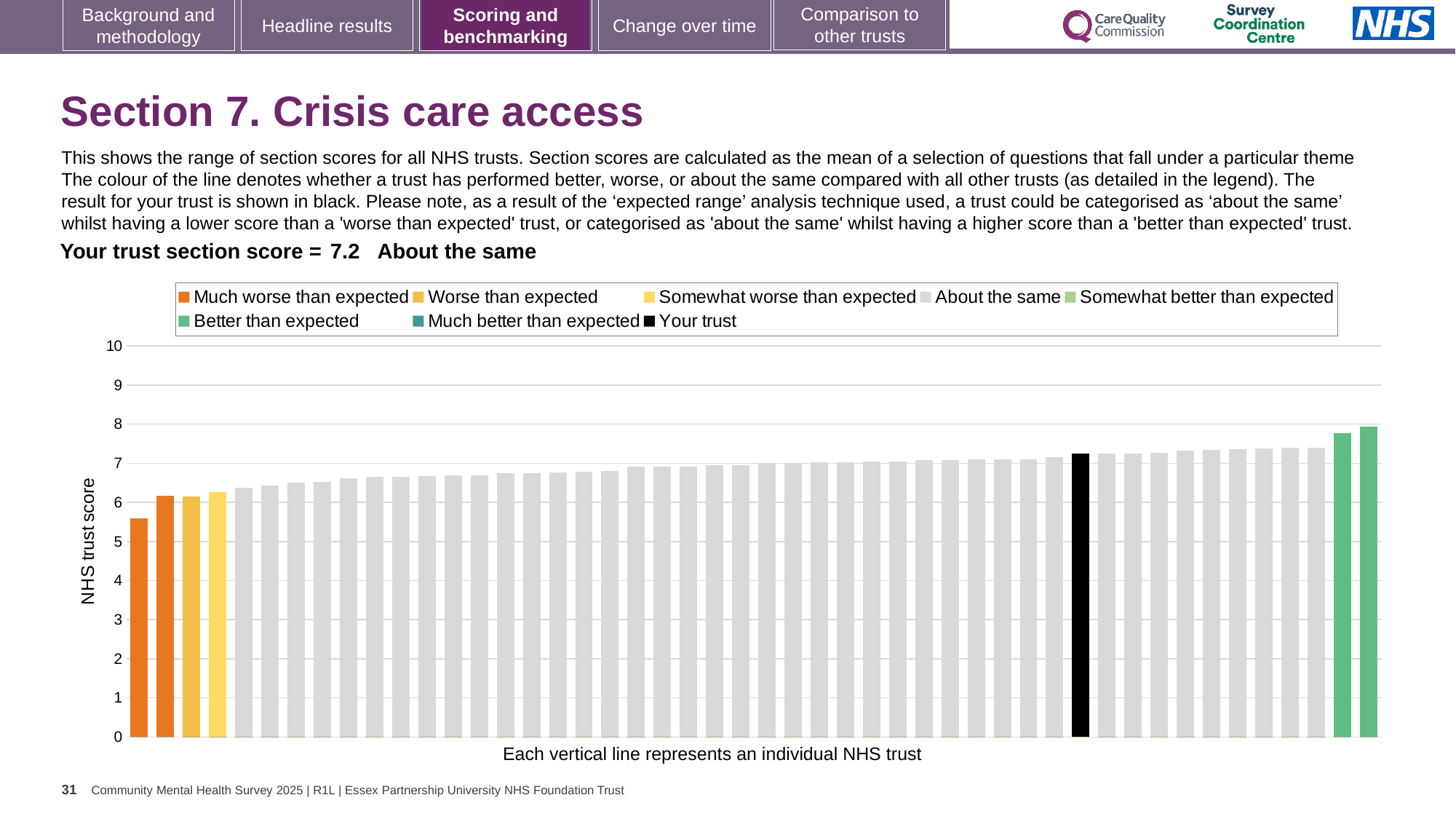
What is the section score for your trust shown on the slide? 7.2 Which legend category does the highest bar on the chart belong to? Better than expected Do the bar values rise or fall from left to right along the x axis? rise How many bars are coloured as 'Much worse than expected'? 2 How many bars are coloured as 'Better than expected'? 2 Is the value for your trust (the black bar) greater or less than 7? greater Is the value for the leftmost bar greater or less than 6? less How many entries does the chart legend list? 8 Is the value for the rightmost bar greater or less than 7? greater What kind of chart is shown on the slide? Bar chart What is the label on the vertical axis of the chart? NHS trust score Which category is your trust placed in for this section? About the same